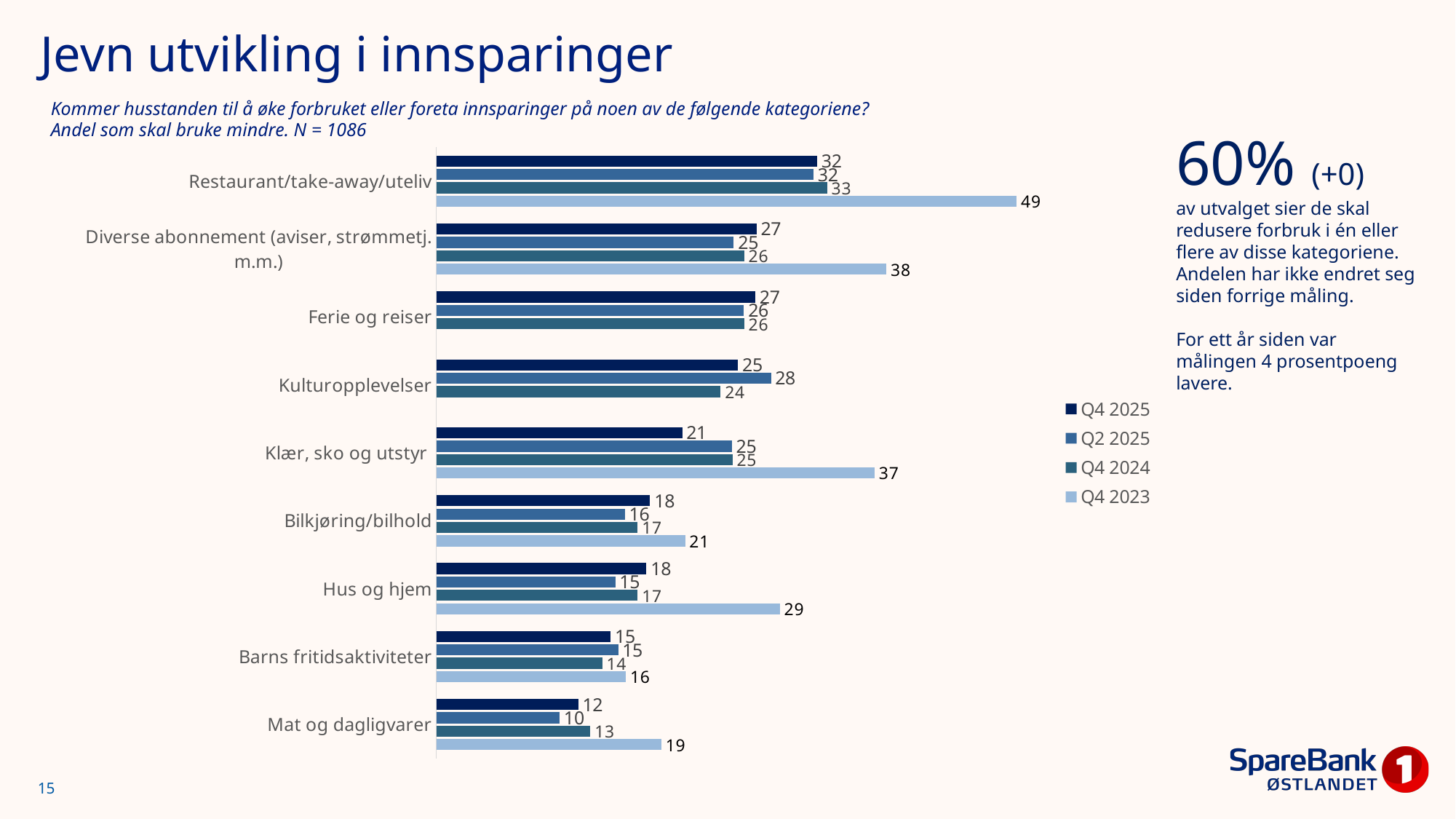
What is the Q2 2025 value for Kulturopplevelser? 28 Which category has the highest Q4 2025 value? Restaurant/take-away/uteliv What is the Q4 2025 value for Restaurant/take-away/uteliv? 32 What is the Q4 2024 value for Bilkjøring/bilhold? 17 What is the Q4 2023 value for Hus og hjem? 29 How many series does the legend list? 4 What kind of chart is shown on the slide? Bar chart What is the difference between the Q4 2023 and Q4 2025 values for Restaurant/take-away/uteliv? 17 Which is larger for Klær, sko og utstyr: the Q4 2025 value or the Q2 2025 value? Q2 2025 Which series is shown in the lightest blue colour in the legend? Q4 2023 How many categories are shown on the chart? 9 Which category has the lowest Q2 2025 value? Mat og dagligvarer